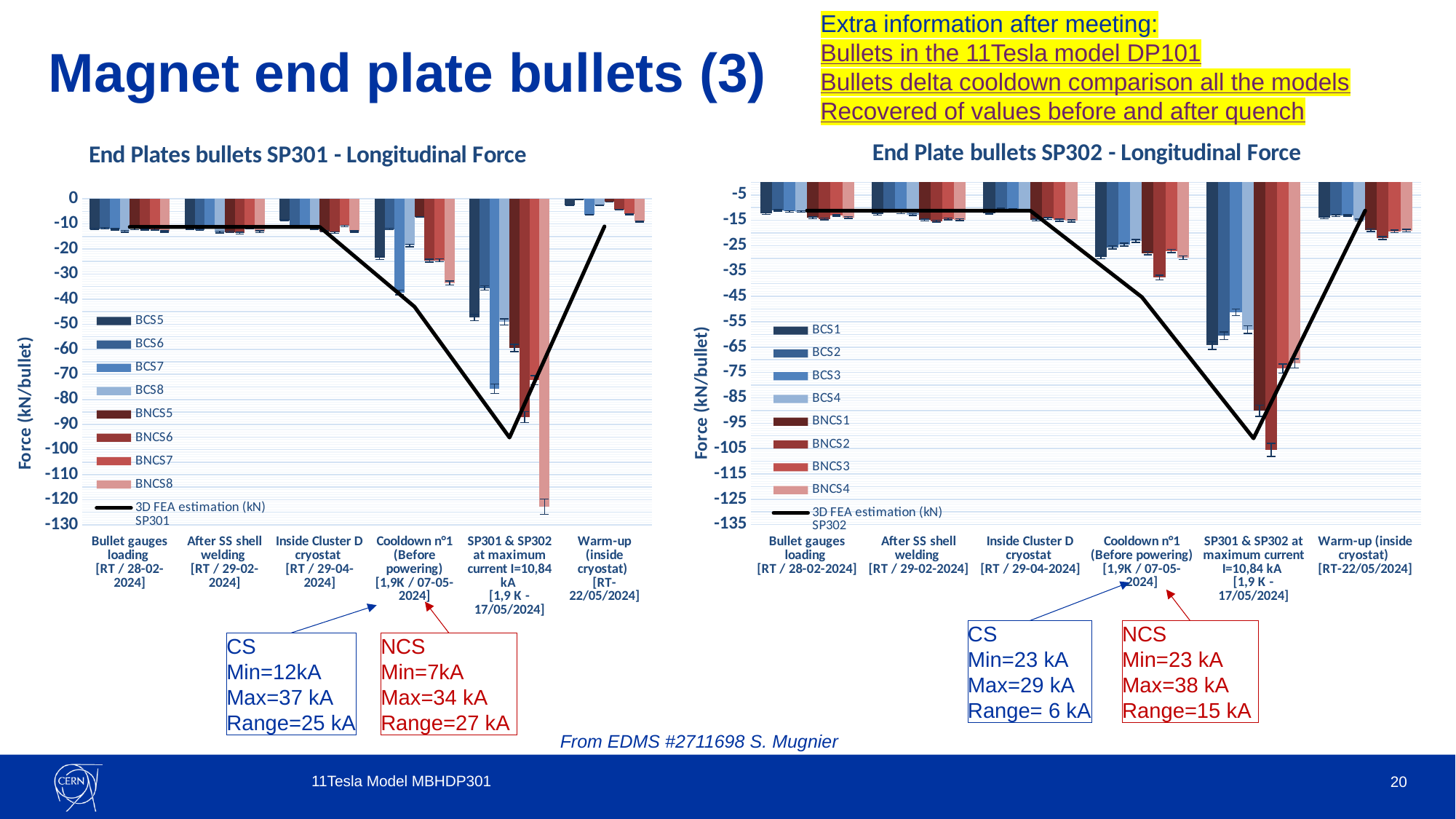
How many entries does the legend of the 'End Plates bullets SP301 - Longitudinal Force' chart list? 9 In the 'End Plates bullets SP301 - Longitudinal Force' chart, what is the last legend entry? 3D FEA estimation (kN) SP301 What is the y-axis title of the 'End Plate bullets SP302 - Longitudinal Force' chart? Force (kN/bullet) In the 'End Plates bullets SP301 - Longitudinal Force' chart, is the value for BNCS8 at 'SP301 & SP302 at maximum current' greater or less than -100? less How many categories are shown on the x axis of the 'End Plate bullets SP302 - Longitudinal Force' chart? 6 In the 'End Plate bullets SP302 - Longitudinal Force' chart, which series has the most negative value at 'SP301 & SP302 at maximum current I=10,84 kA'? BNCS2 In the 'End Plate bullets SP302 - Longitudinal Force' chart, is the value for BNCS1 at 'SP301 & SP302 at maximum current' greater or less than -95? greater What type of chart is 'End Plates bullets SP301 - Longitudinal Force'? bar and line chart In the 'End Plates bullets SP301 - Longitudinal Force' chart, at 'SP301 & SP302 at maximum current', which is more negative: BCS8 or BNCS5? BNCS5 In the 'End Plate bullets SP302 - Longitudinal Force' chart, does the '3D FEA estimation (kN) SP302' line fall or rise between 'Cooldown n°1' and 'SP301 & SP302 at maximum current'? fall In the 'End Plates bullets SP301 - Longitudinal Force' chart, which series has the most negative value at 'SP301 & SP302 at maximum current I=10,84 kA'? BNCS8 In the 'End Plates bullets SP301 - Longitudinal Force' chart, is the value for BCS5 at 'Bullet gauges loading' greater or less than -20? greater